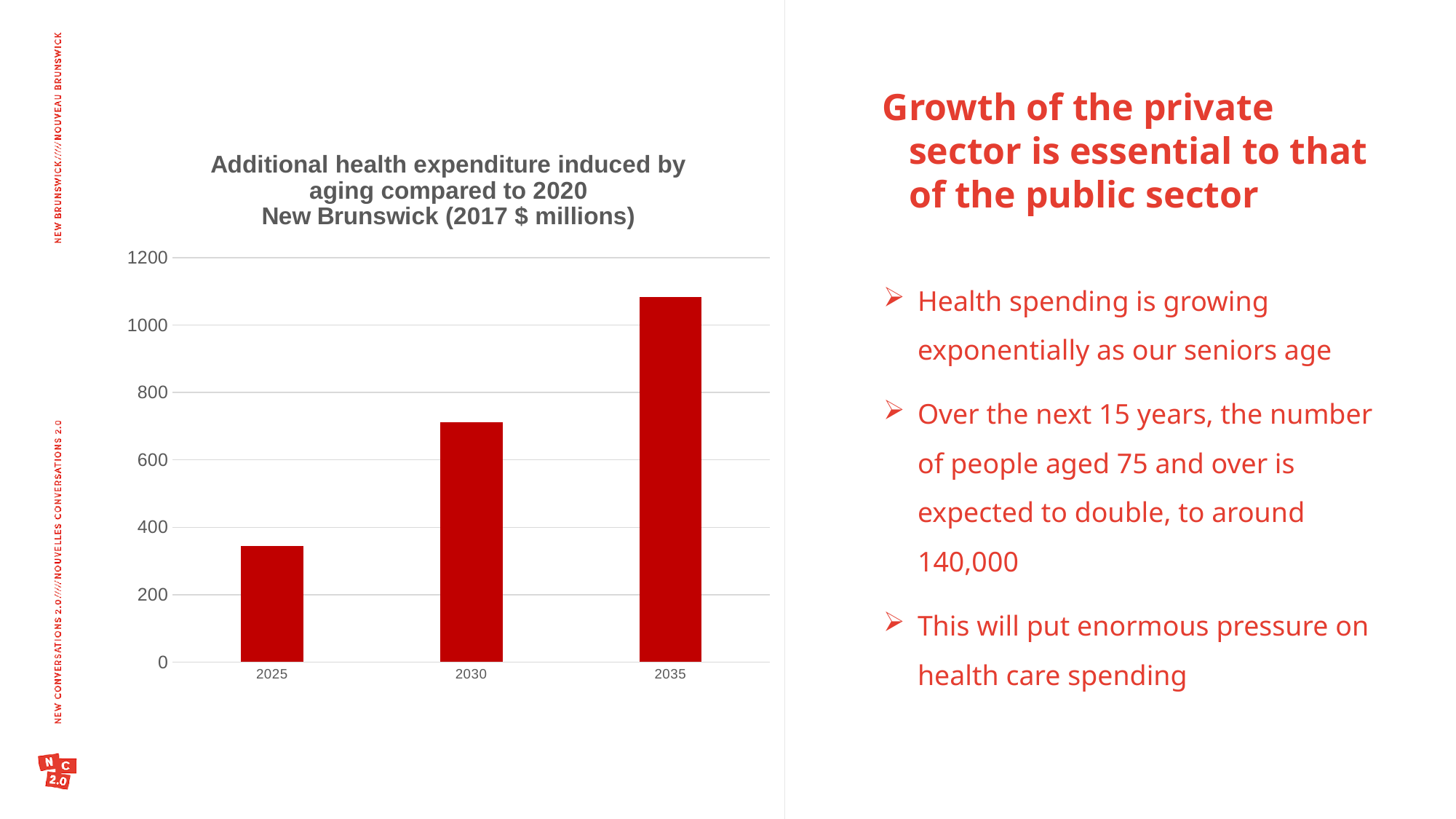
Is the value for 2035 greater or less than 1000? greater What is the title of the chart? Additional health expenditure induced by aging compared to 2020 New Brunswick (2017 $ millions) How many bars (categories) does the chart show? 3 Is the value for 2030 greater or less than 800? less Which is larger, the value for 2030 or the value for 2035? 2035 What kind of chart is shown on the slide? bar chart What colour are the bars in the chart? red Is the value for 2030 greater or less than 600? greater Do the values rise or fall from 2025 to 2035? rise Which year has the lowest additional health expenditure? 2025 Which year has the highest additional health expenditure? 2035